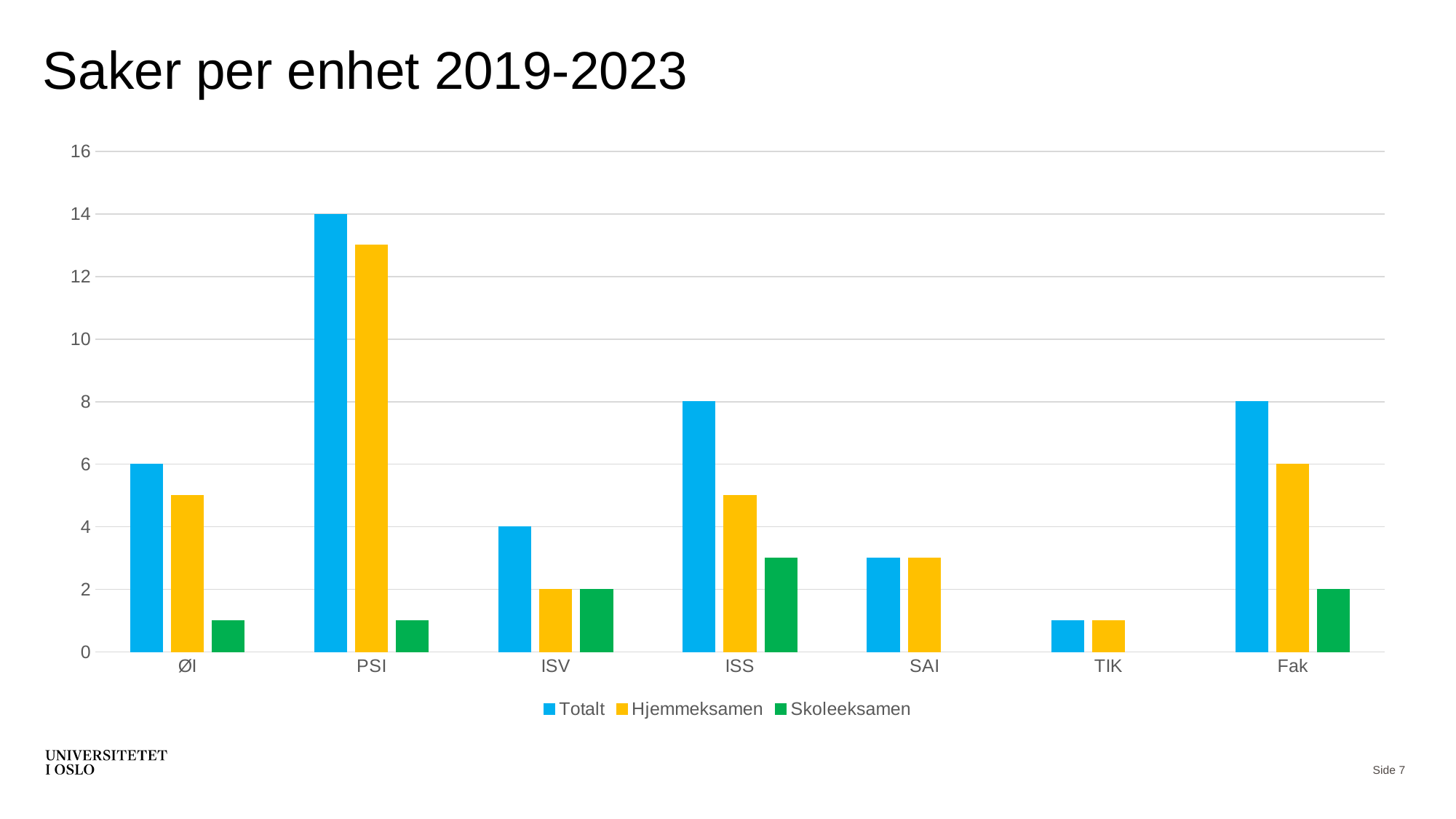
Which category has the lowest Totalt value? TIK What is the Totalt value for ØI? 6 What is the difference between the Totalt values for PSI and ISS? 6 Is the Hjemmeksamen value for PSI greater or less than 12? greater What is the Hjemmeksamen value for Fak? 6 What is the Skoleeksamen value for ISV? 2 Which is larger, the Totalt value for ISS or the Totalt value for SAI? ISS Which category has the highest Totalt value? PSI What kind of chart is shown on the slide? bar chart How many categories are shown on the x axis? 7 What is the Totalt value for PSI? 14 How many series does the legend list? 3